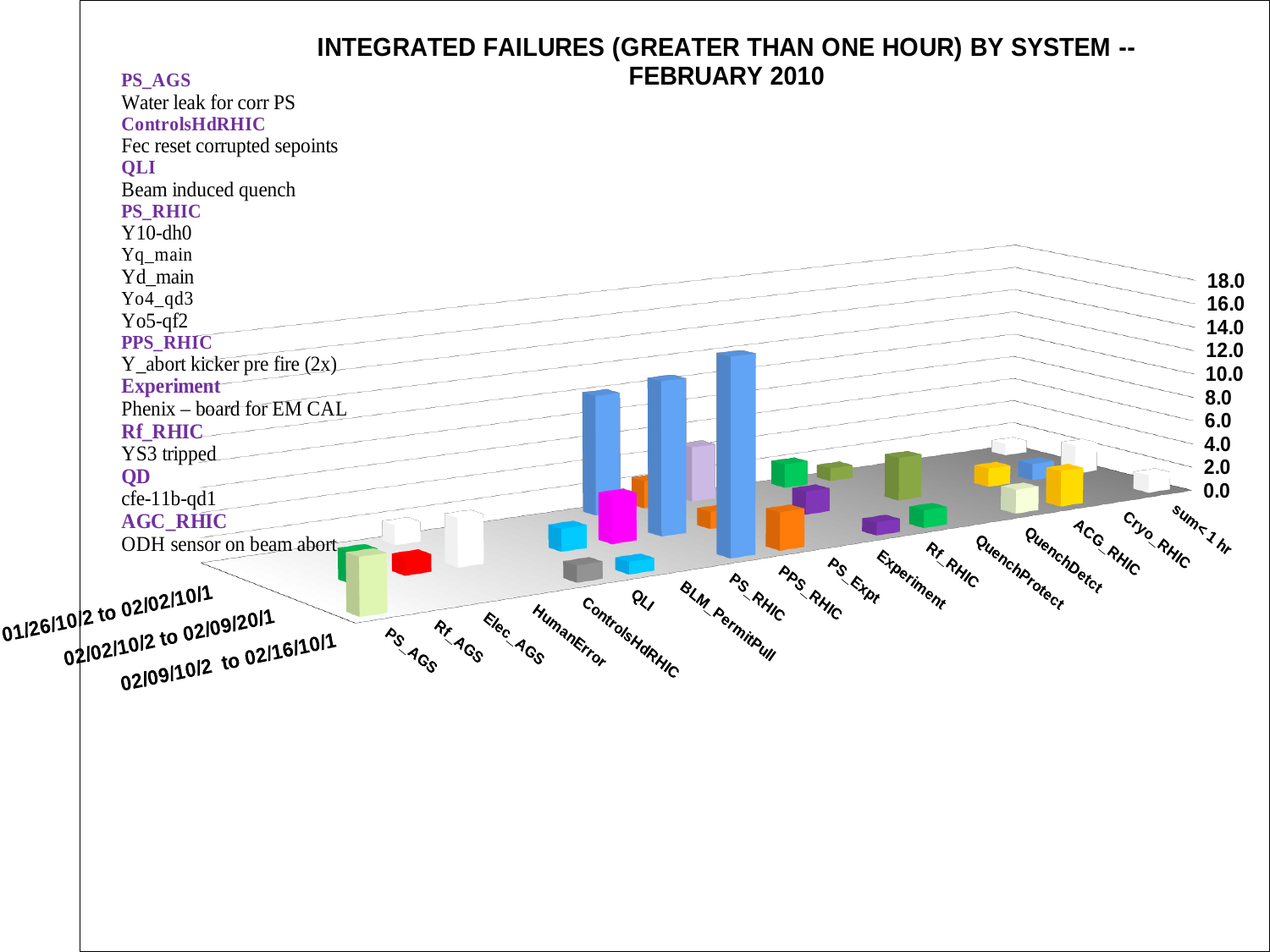
What is the highest value shown on the chart's vertical axis? 18.0 What is the title of the chart? INTEGRATED FAILURES (GREATER THAN ONE HOUR) BY SYSTEM -- FEBRUARY 2010 How many date-range periods are plotted in the chart? 3 How many system categories are listed along the x axis of the chart? 17 Which date range is plotted in the front row of the chart? 02/09/10/2 to 02/16/10/1 What kind of chart is shown on the slide? bar chart Which system category is listed first on the x axis of the chart? PS_AGS Which category is listed last on the x axis of the chart? sum< 1 hr